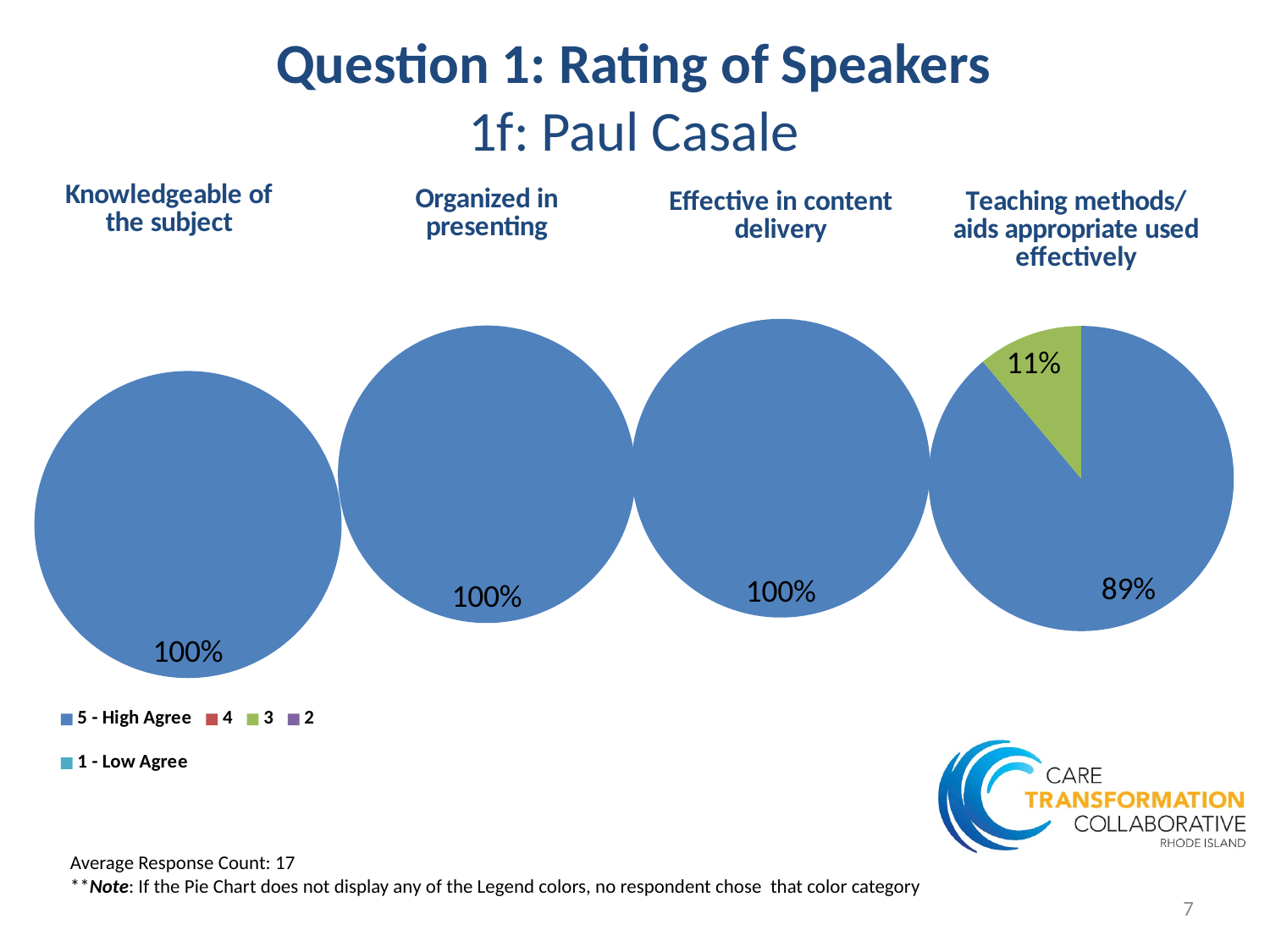
In the 'Knowledgeable of the subject' pie chart, what share of responses is '5 - High Agree'? 100% How many pie charts are shown on the slide? 4 How many rating categories does the legend list? 5 In the 'Teaching methods/aids appropriate used effectively' pie chart, what is the difference between the '5 - High Agree' share and the '3' share? 78% What type of chart is used for each of the four ratings on this slide? Pie chart In the 'Effective in content delivery' pie chart, what percentage is shown on the single slice? 100% In the 'Teaching methods/aids appropriate used effectively' pie chart, which rating category has the largest slice? 5 - High Agree In the 'Teaching methods/aids appropriate used effectively' pie chart, which rating category has the smallest slice? 3 In the 'Organized in presenting' pie chart, what percentage is shown on the single slice? 100% In the 'Teaching methods/aids appropriate used effectively' pie chart, what share of responses is rated '3'? 11% In the 'Teaching methods/aids appropriate used effectively' pie chart, what share of responses is '5 - High Agree'? 89% In the 'Teaching methods/aids appropriate used effectively' pie chart, which is larger: the '5 - High Agree' slice or the '3' slice? 5 - High Agree